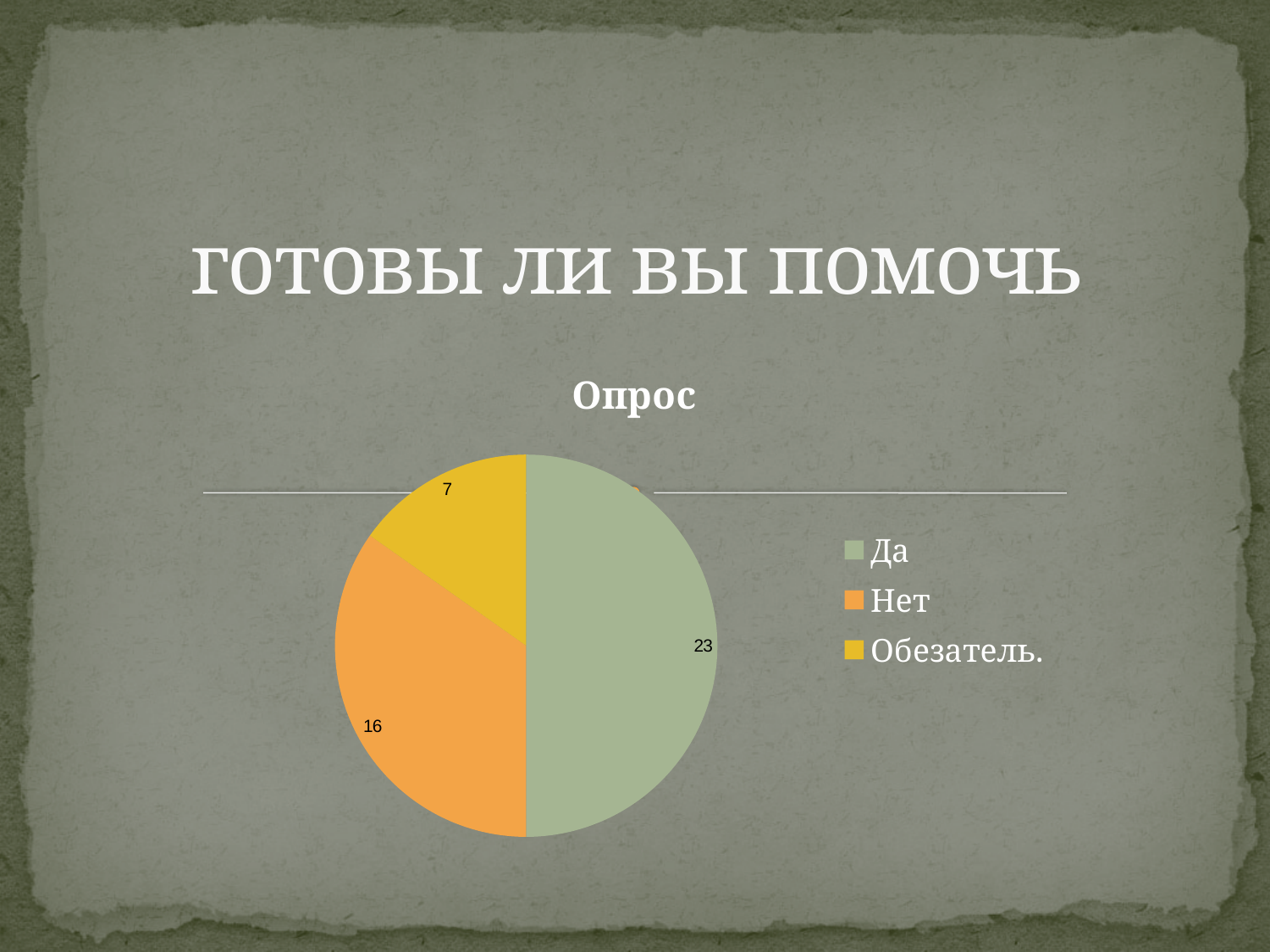
What is the value for Обезатель.? 7 What share of the pie does the Да slice represent? 50% What is the value for Нет? 16 How many slices does the pie chart have? 3 Which category has the largest slice? Да What is the difference between the values for Да and Нет? 7 What kind of chart is shown on the slide? pie chart What is the title of the chart? Опрос What is the difference between the values for Нет and Обезатель.? 9 Which category has the smallest slice? Обезатель. Which is larger, the value for Нет or the value for Обезатель.? Нет What is the value for Да? 23